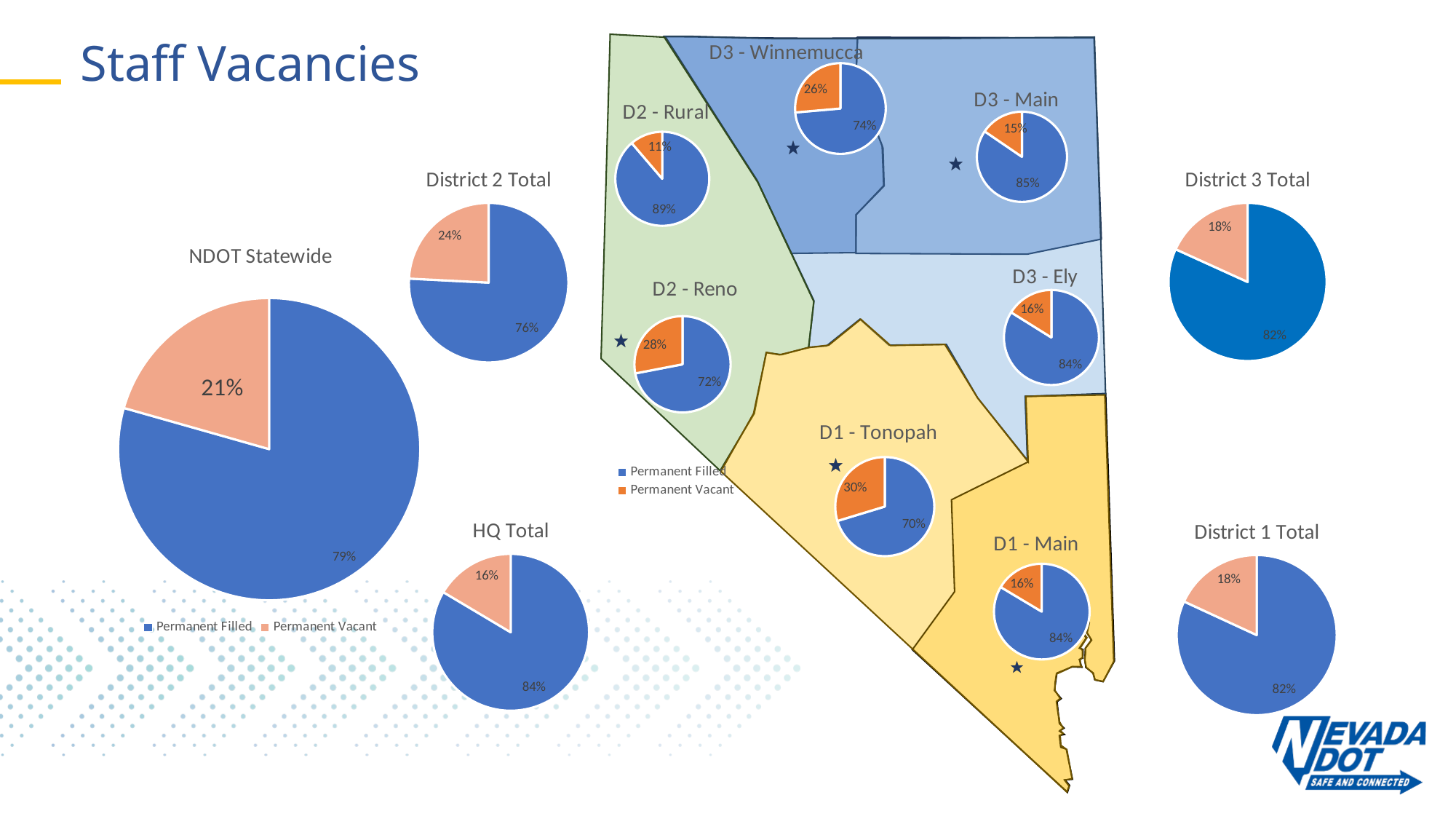
In the D1 - Tonopah chart, what share is Permanent Vacant? 30% In the NDOT Statewide chart, what share is Permanent Vacant? 21% Which of the two slices in the D2 - Reno chart is larger, Permanent Filled or Permanent Vacant? Permanent Filled How many series does the legend below the NDOT Statewide chart list? 2 What is the difference between the Permanent Filled shares in the D3 - Main chart and the D3 - Ely chart? 1% Which chart has the larger Permanent Vacant share, District 2 Total or District 3 Total? District 2 Total What kind of chart is the NDOT Statewide chart? Pie chart In the HQ Total chart, what share is Permanent Vacant? 16% In the District 1 Total chart, what share is Permanent Filled? 82% In the District 2 Total chart, what share is Permanent Filled? 76% In the D3 - Winnemucca chart, what share is Permanent Vacant? 26% In the D2 - Rural chart, what share is Permanent Filled? 89%